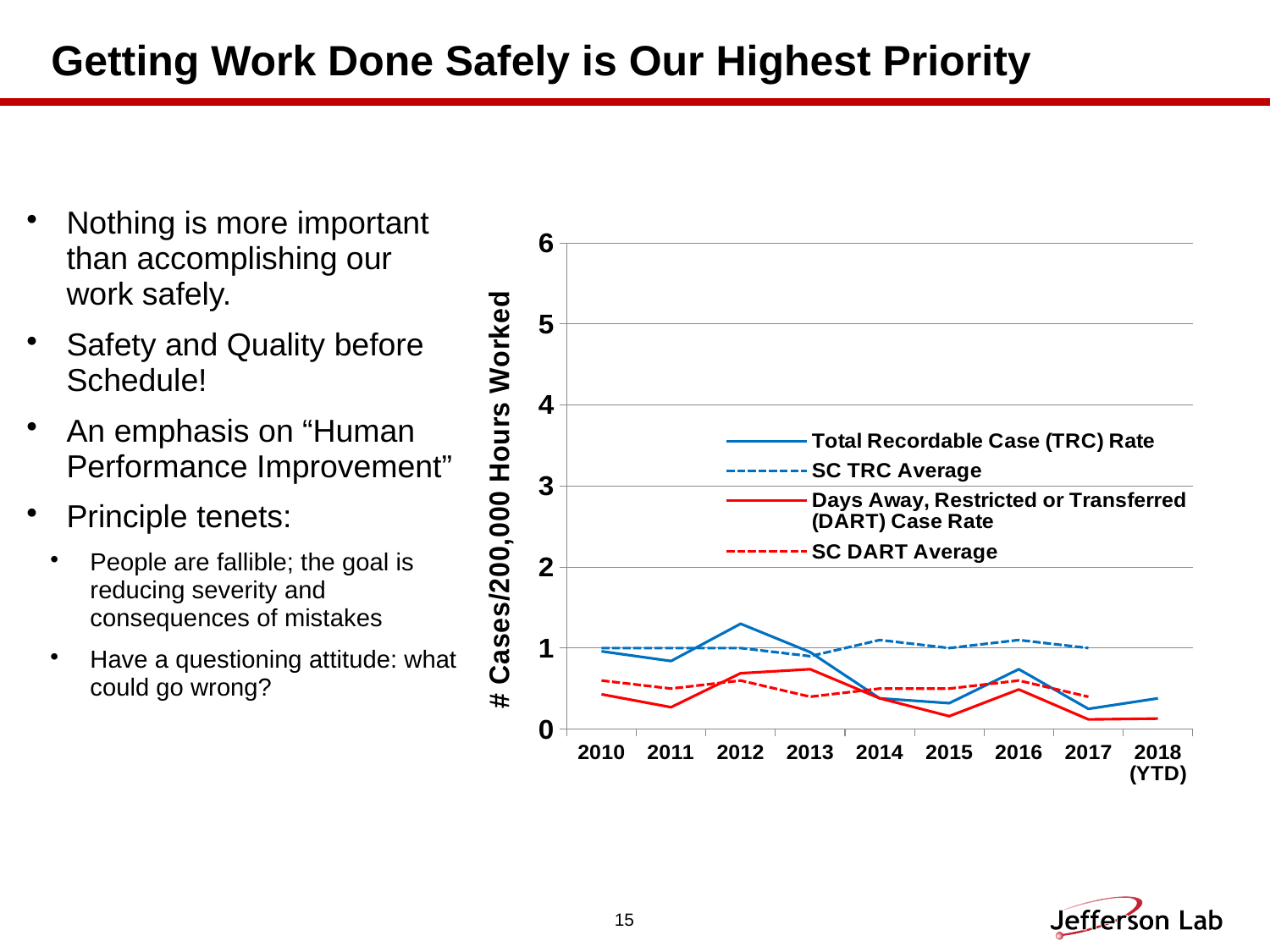
Which is larger in 2012: the Total Recordable Case (TRC) Rate or the Days Away, Restricted or Transferred (DART) Case Rate? Total Recordable Case (TRC) Rate What is the title of the chart's vertical axis? # Cases/200,000 Hours Worked How many years are labelled along the x axis of the chart? 9 In which year does the Days Away, Restricted or Transferred (DART) Case Rate reach its highest value? 2013 Does the Total Recordable Case (TRC) Rate rise or fall from 2013 to 2015? fall What colour is the line for the Days Away, Restricted or Transferred (DART) Case Rate? red Is the SC TRC Average for 2014 greater or less than 2? less Is the Total Recordable Case (TRC) Rate for 2012 greater or less than 1? greater What kind of chart is shown on the slide? line chart Is the Total Recordable Case (TRC) Rate for 2015 greater or less than 1? less In which year does the Total Recordable Case (TRC) Rate reach its highest value? 2012 How many series does the chart legend list? 4